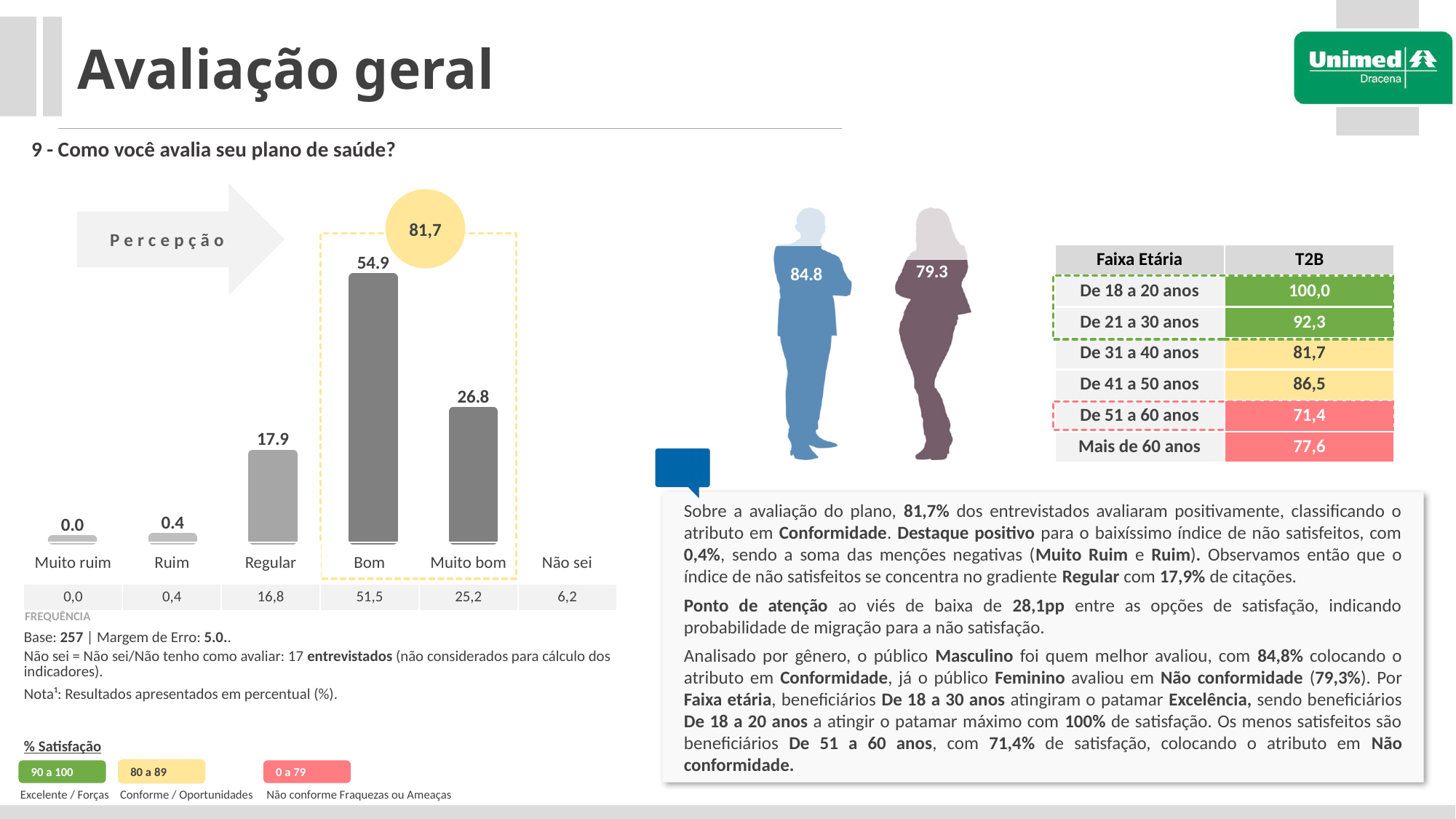
Do the bar values rise or fall from Regular to Bom? rise What is the difference between the values for Bom and Muito bom? 28.1 What value is printed in the yellow circle above the dashed box around Bom and Muito bom? 81,7 How many category labels appear along the x axis of the bar chart? 6 Which category has the highest bar in the chart? Bom What is the value shown for the Regular bar? 17.9 What is the value shown for the Muito bom bar? 26.8 What is the value shown for the Ruim bar? 0.4 Which is larger, the value for Regular or the value for Muito bom? Muito bom What kind of chart is shown on the left of the slide? bar chart What is the value shown for the Bom bar? 54.9 Which category has the lowest labelled value in the chart? Muito ruim